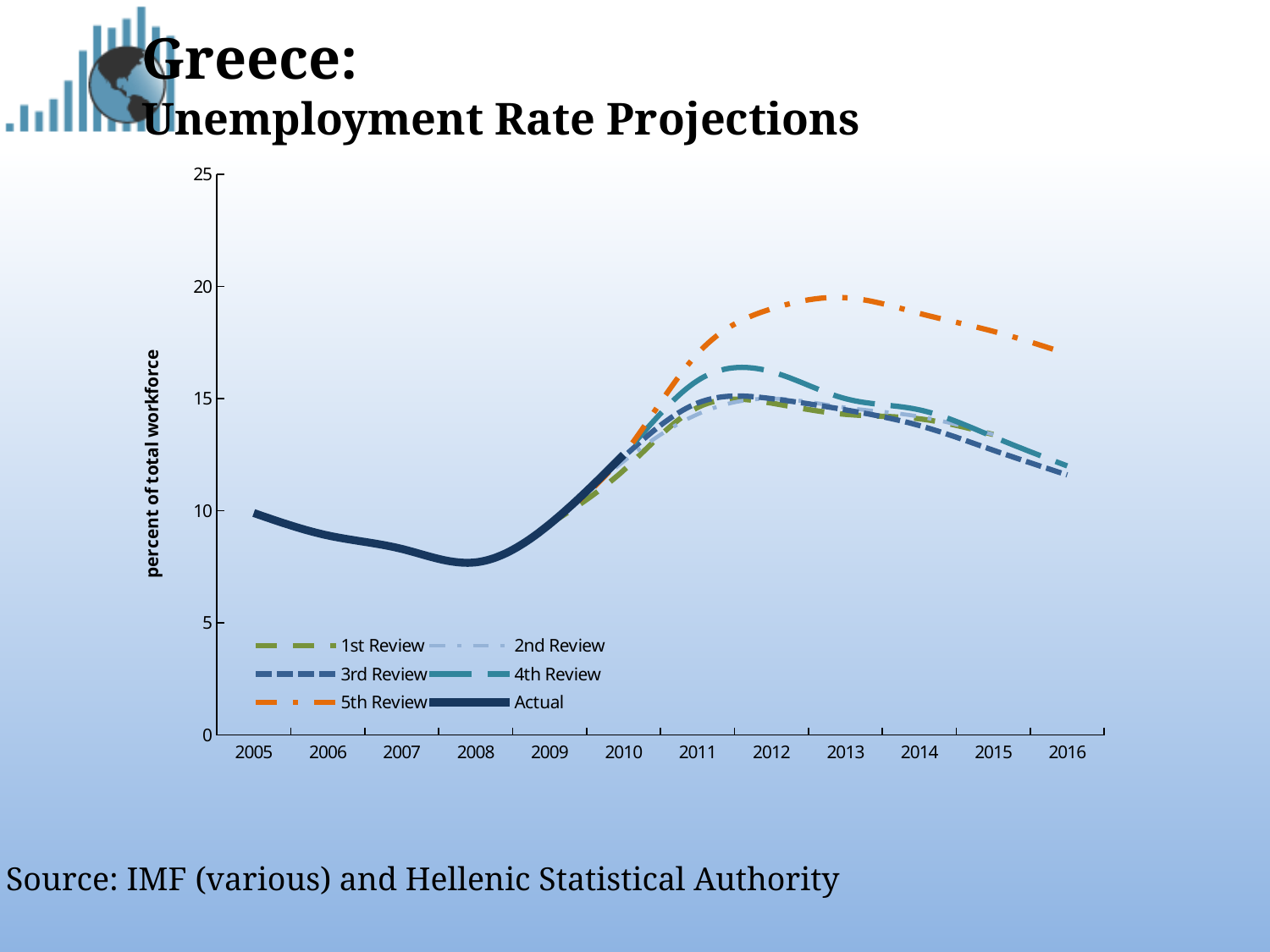
Does the Actual series rise or fall from 2008 to 2010? rise Is the value of the 3rd Review series in 2016 greater or less than 15? less How many series does the legend list? 6 Is the value of the 5th Review series in 2013 greater or less than 15? greater Is the value of the Actual series in 2008 greater or less than 10? less Which series reaches the highest value on the chart? 5th Review Does the Actual series rise or fall from 2005 to 2008? fall What kind of chart is shown on the slide? line chart In 2014, which is higher: the 5th Review series or the 3rd Review series? 5th Review Does the 5th Review series rise or fall from 2013 to 2016? fall What is the label on the vertical axis of the chart? percent of total workforce